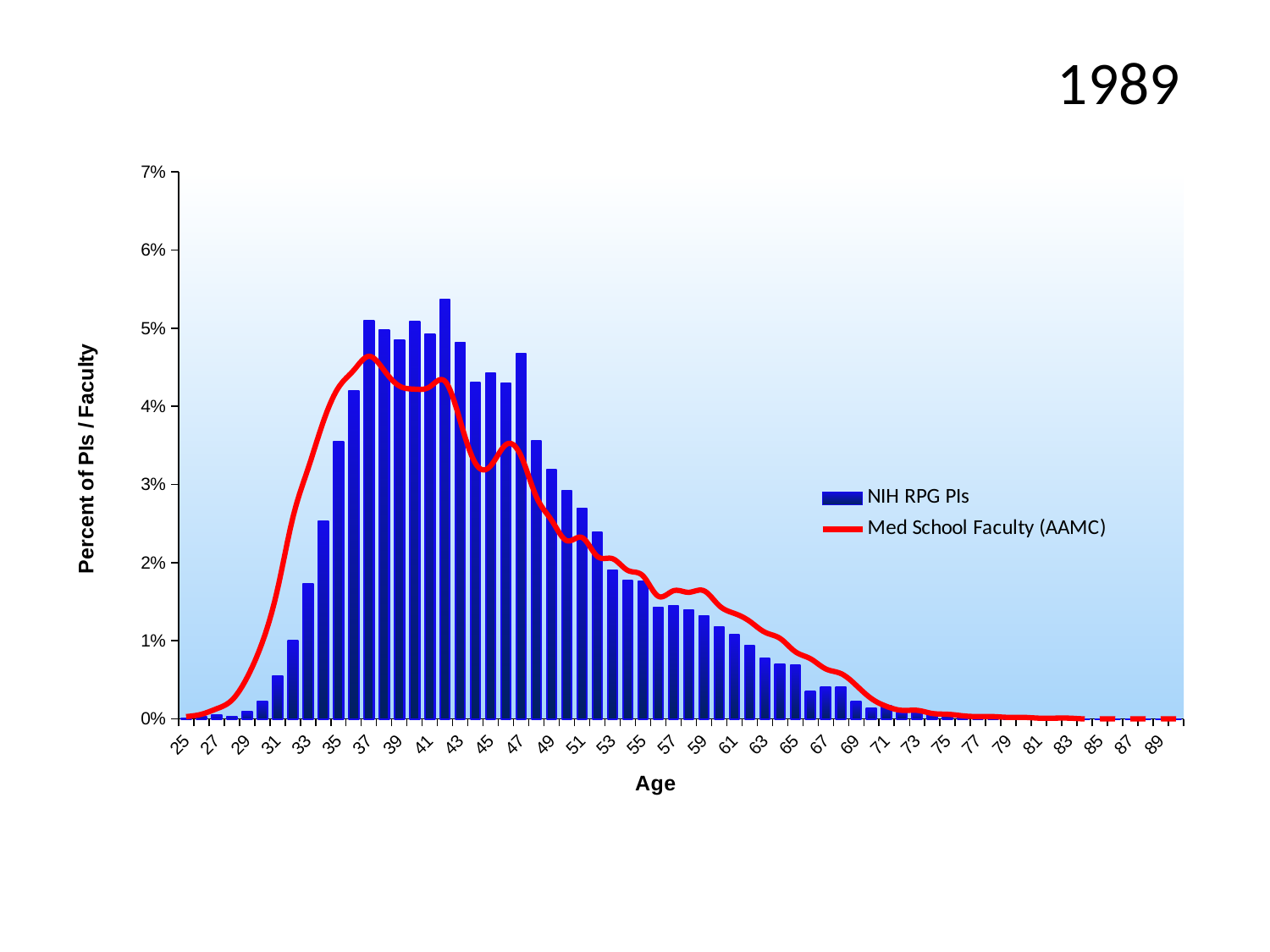
How many series does the legend list? 2 Is the Med School Faculty (AAMC) value at age 60 greater or less than 2%? less Is the Med School Faculty (AAMC) value at age 37 greater or less than 4%? greater Is the NIH RPG PIs value at age 65 greater or less than 1%? less What year is shown as the title of the chart? 1989 What kind of chart is used to show the NIH RPG PIs series? Bar chart Do the NIH RPG PIs values generally rise or fall from age 50 to age 70? fall At which age is the NIH RPG PIs bar the highest? 42 At age 35, which is larger: the NIH RPG PIs bar or the Med School Faculty (AAMC) line? Med School Faculty (AAMC) At age 47, which is larger: the NIH RPG PIs bar or the Med School Faculty (AAMC) line? NIH RPG PIs